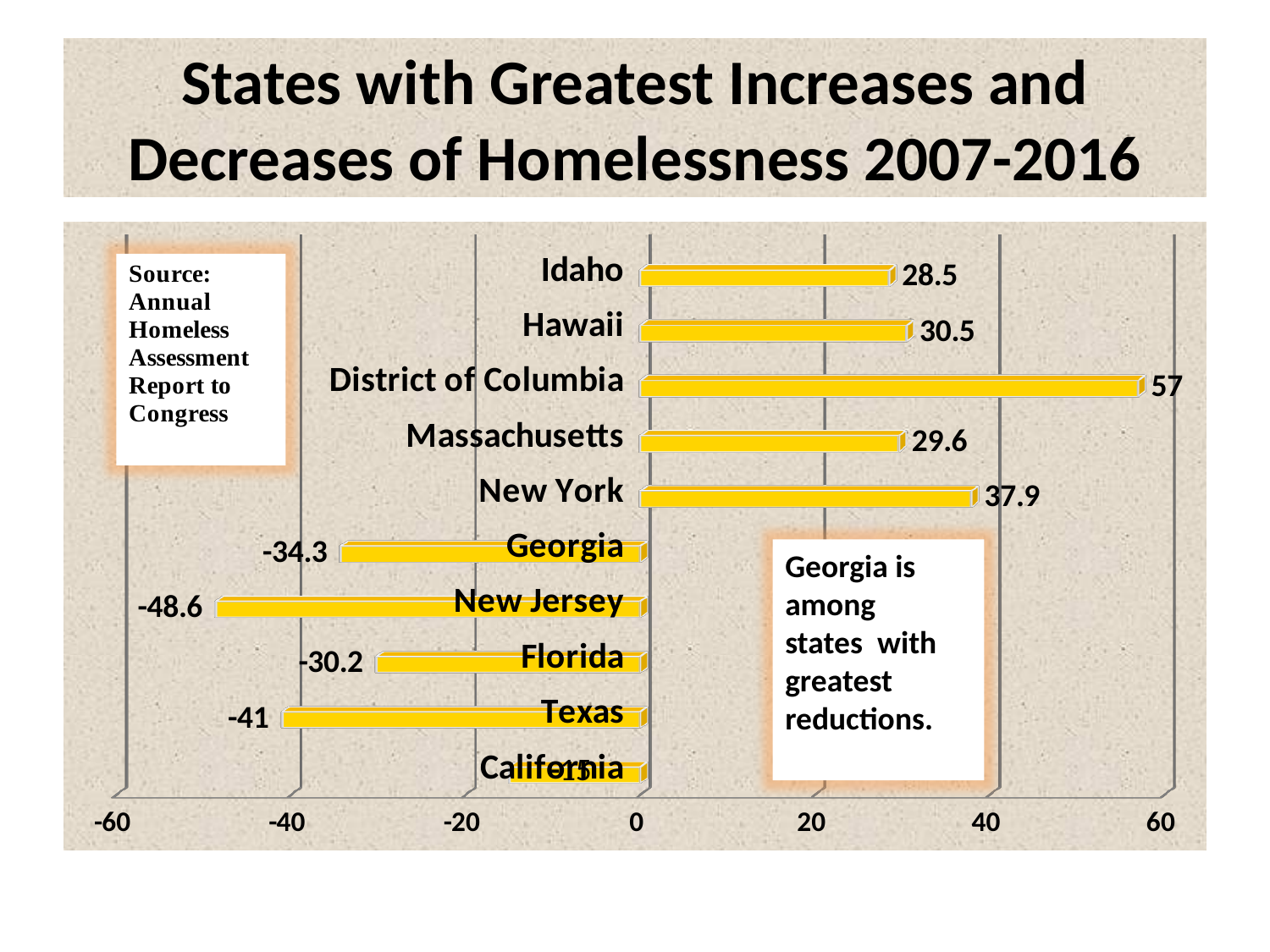
Which state has the lowest value? New Jersey What kind of chart is shown on the slide? bar chart Is the value for Georgia greater or less than -20? less What is the value for District of Columbia? 57 Which state has the highest value? District of Columbia What is the title of the slide? States with Greatest Increases and Decreases of Homelessness 2007-2016 What is the value for New Jersey? -48.6 What is the value for New York? 37.9 Which has the larger value, Hawaii or Idaho? Hawaii What is the value for Texas? -41 How many states are shown in the chart? 10 What is the difference between the values for District of Columbia and New York? 19.1